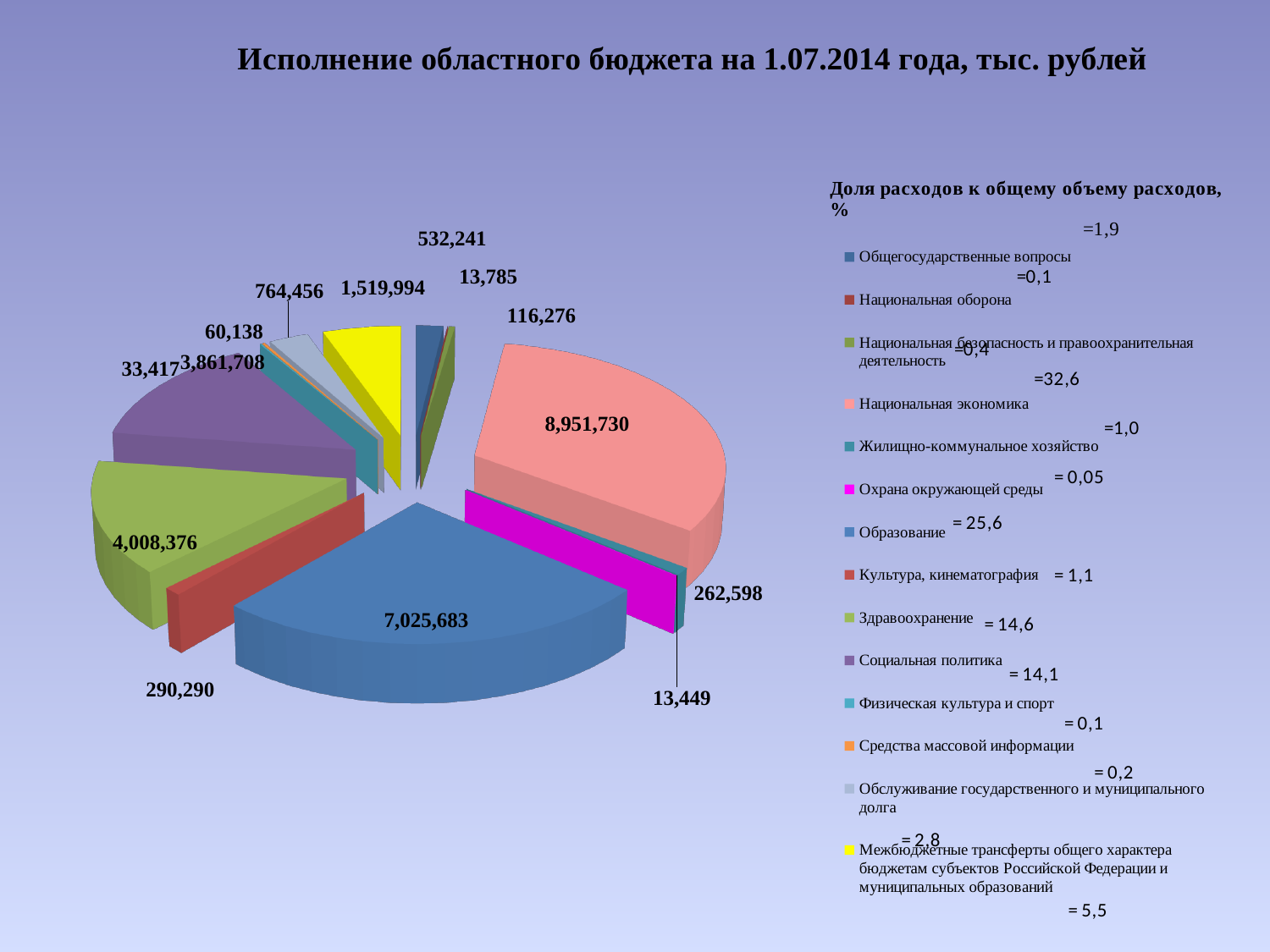
Which category has the smallest value in the pie chart? Охрана окружающей среды What is the title of the chart on the slide? Исполнение областного бюджета на 1.07.2014 года, тыс. рублей Which is larger, the value for Здравоохранение or the value for Социальная политика? Здравоохранение How many categories does the legend of the pie chart list? 14 What is the difference between the values for Национальная экономика and Образование? 1,926,047 What share of total expenditure does Национальная экономика account for, according to the legend? 32,6 What kind of chart is shown on the slide? pie chart What is the value for Национальная экономика? 8,951,730 What is the value for Образование? 7,025,683 Which category has the largest slice of the pie? Национальная экономика What is the value for Здравоохранение? 4,008,376 What is the value for Социальная политика? 3,861,708